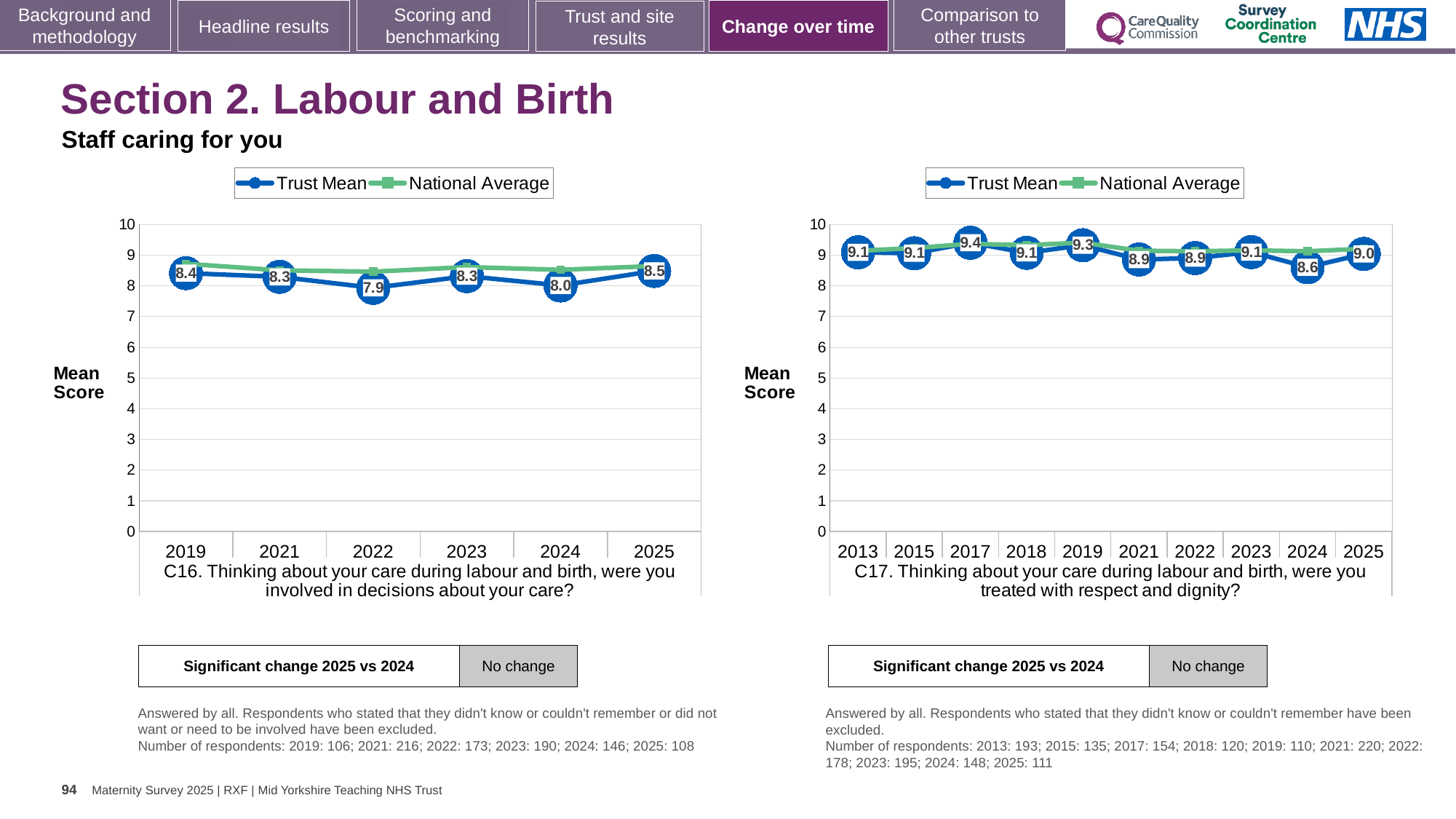
In the C16 chart (left), what is the Trust Mean score for 2022? 7.9 In the C17 chart (right), what is the Trust Mean score for 2017? 9.4 In the C16 chart (left), which year has the highest Trust Mean score? 2025 In the C16 chart (left), what is the difference between the Trust Mean scores for 2025 and 2024? 0.5 In the C17 chart (right), which year has the highest Trust Mean score? 2017 In the C17 chart (right), which year has the lowest Trust Mean score? 2024 In the C16 chart (left), how many years are shown on the x axis? 6 What type of chart is used for the C17 chart (right)? Line chart In the C16 chart (left), which year has the lowest Trust Mean score? 2022 In the C17 chart (right), is the Trust Mean score for 2019 larger than the score for 2021? Yes, 2019 (9.3) In the C16 chart (left), what is the Trust Mean score for 2025? 8.5 In the C17 chart (right), how many series does the legend list? 2